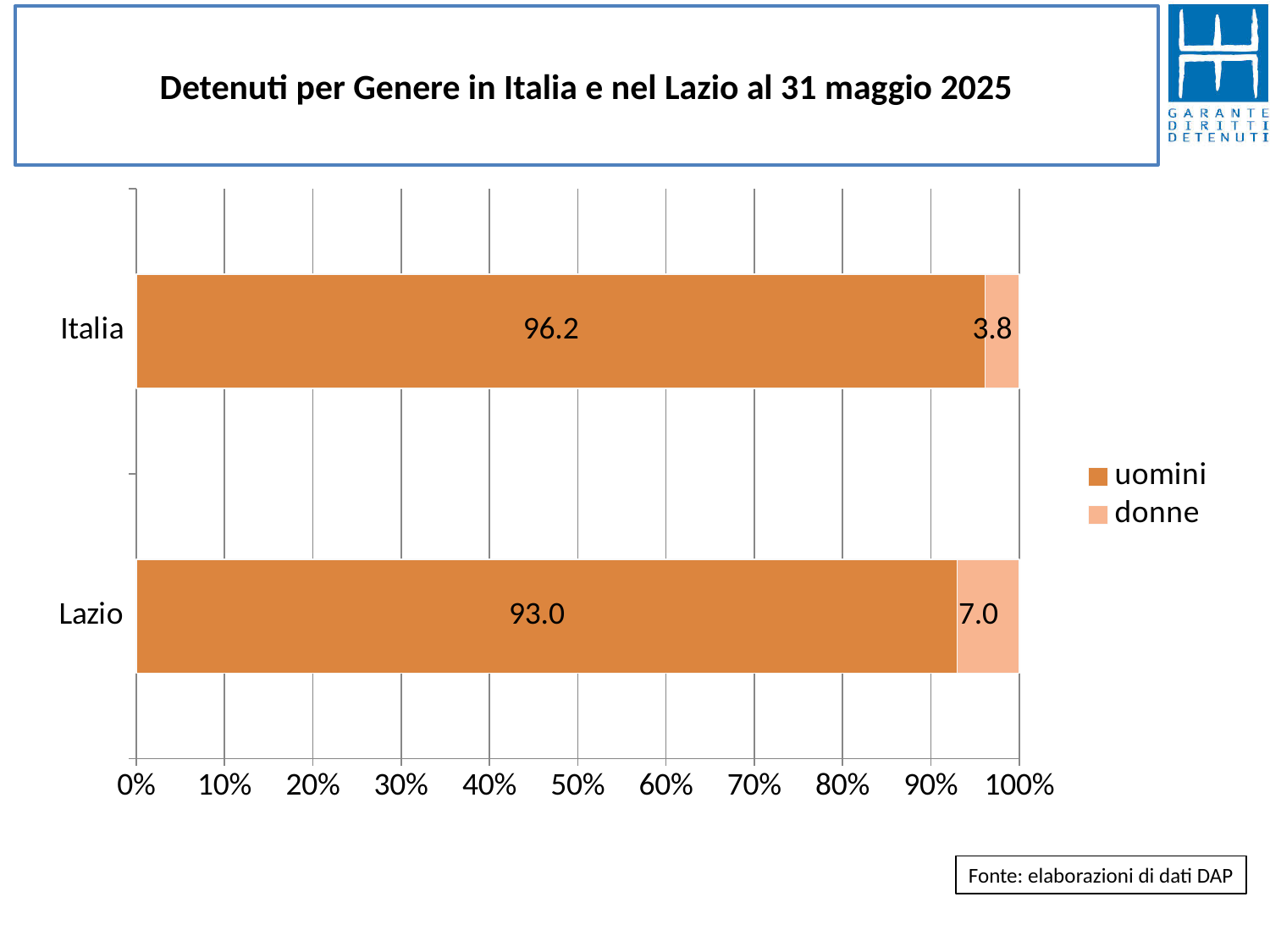
How many series does the legend list? 2 What is the difference between the donne values for Lazio and Italia? 3.2 Which category has the highest value for uomini? Italia How many categories are shown on the chart? 2 What is the title of the chart? Detenuti per Genere in Italia e nel Lazio al 31 maggio 2025 What is the value for donne in Italia? 3.8 Which category has the higher value for donne, Italia or Lazio? Lazio What is the value for uomini in Lazio? 93.0 What is the difference between the uomini values for Italia and Lazio? 3.2 What kind of chart is shown on the slide? Stacked bar chart What is the value for donne in Lazio? 7.0 What is the value for uomini in Italia? 96.2